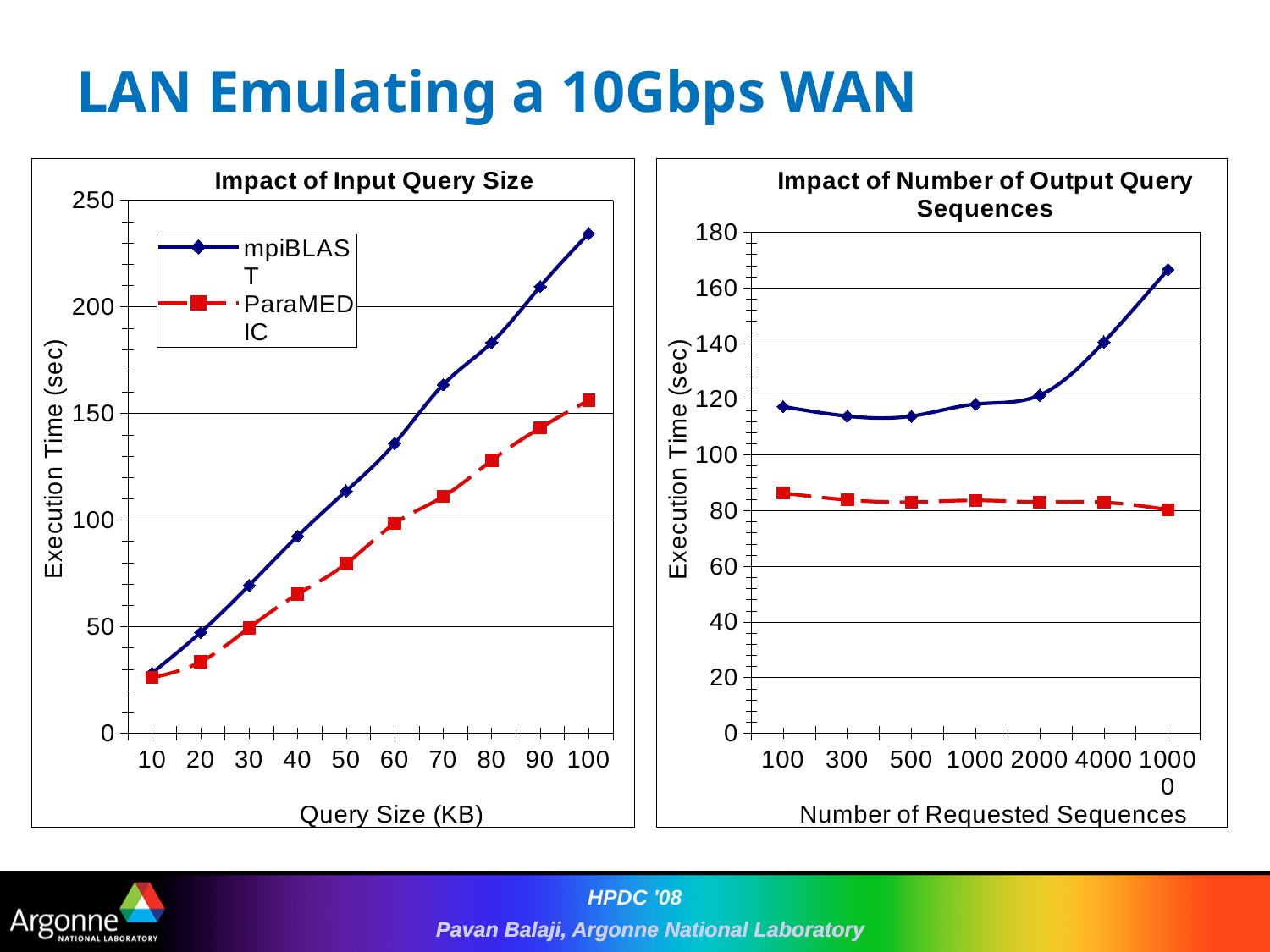
In the 'Impact of Input Query Size' chart, is the mpiBLAST execution time at a query size of 10 KB greater or less than 50? less In the 'Impact of Number of Output Query Sequences' chart, is the execution time of the blue (mpiBLAST) line at 10000 requested sequences greater or less than 140? greater How many points are plotted along the x axis of the 'Impact of Number of Output Query Sequences' chart? 7 In the 'Impact of Input Query Size' chart, does the execution time for ParaMEDIC rise or fall as query size increases? rise How many series does the legend of the 'Impact of Input Query Size' chart list? 2 In the 'Impact of Input Query Size' chart, at which query size is the mpiBLAST execution time highest? 100 What kind of chart is the 'Impact of Input Query Size' chart? line chart How many query size points are plotted on the x axis of the 'Impact of Input Query Size' chart? 10 In the 'Impact of Input Query Size' chart, is the mpiBLAST execution time at a query size of 100 KB greater or less than 200? greater What is the y-axis label of the 'Impact of Number of Output Query Sequences' chart? Execution Time (sec) In the 'Impact of Input Query Size' chart, which series has the higher execution time at a query size of 100 KB, mpiBLAST or ParaMEDIC? mpiBLAST